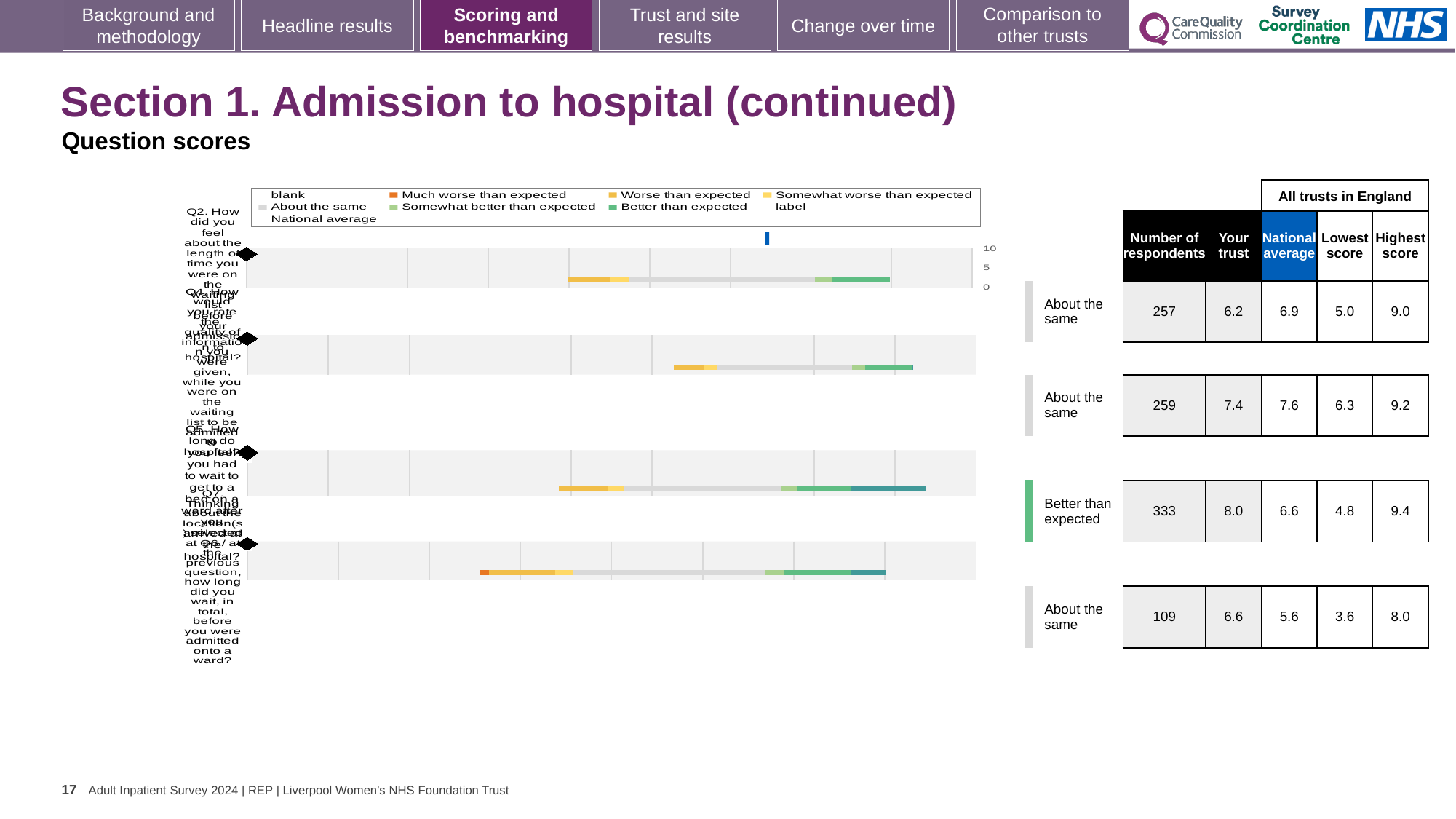
In the table beside the chart, what is the highest score for the second row (Q4)? 9.2 How many entries does the chart legend list? 9 How many question rows are plotted in the chart? 4 What is the highest value shown on the chart's axis? 10 For the first row (Q2), what is the difference between the national average (6.9) and the 'Your trust' score (6.2)? 0.7 Which row has the largest number of respondents in the table beside the chart? the third row (Q5), 333 For the third row (Q5), which is larger: the 'Your trust' score or the national average? Your trust In the table beside the chart, what is the national average for the fourth row (Q7)? 5.6 What kind of chart is shown on the slide? bar chart What colour does the legend use for 'Better than expected'? green In the table beside the chart, what is the number of respondents for the first row (Q2)? 257 In the table beside the chart, what is the 'Your trust' score for the third row (Q5)? 8.0